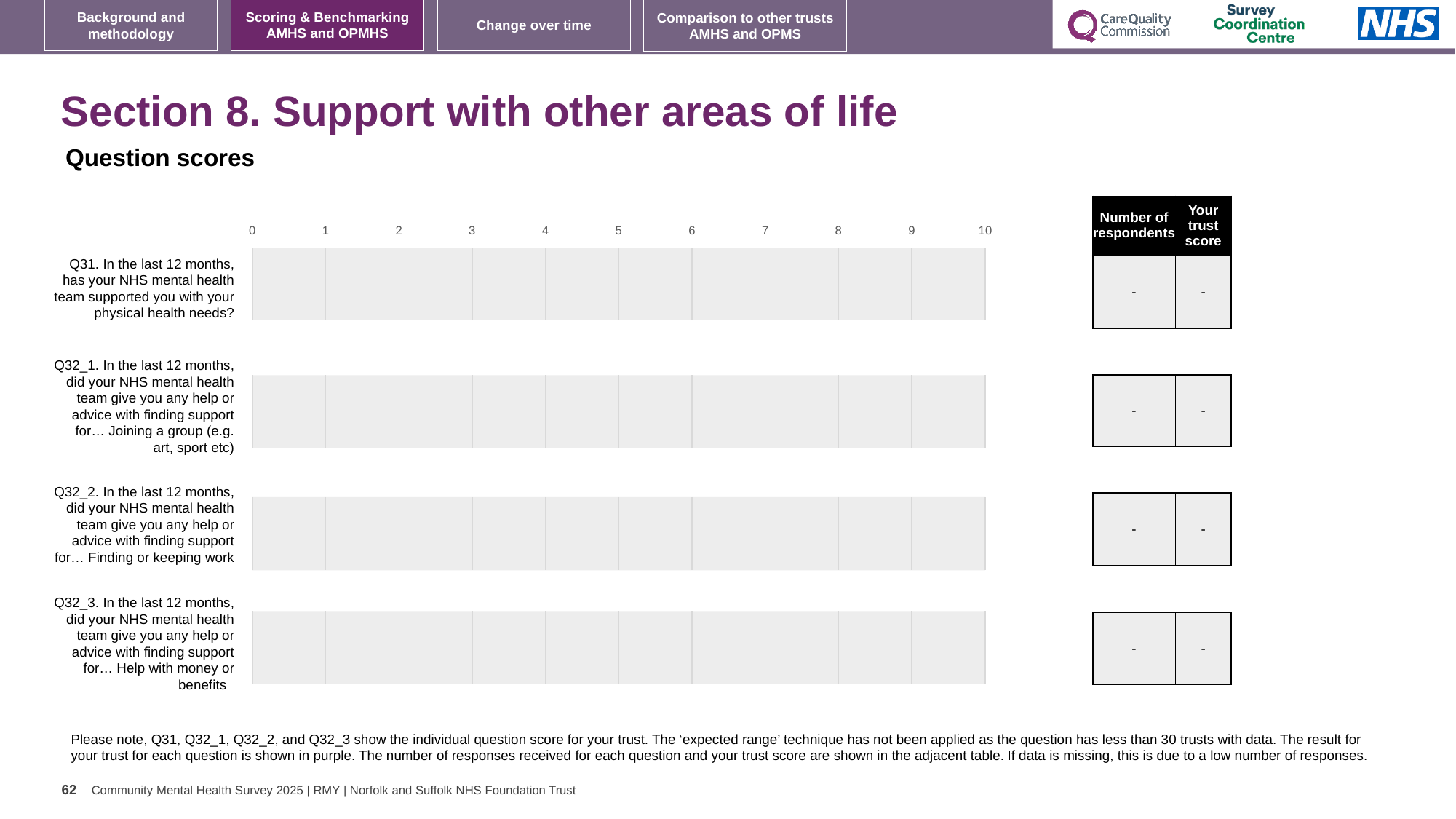
What is the lowest value shown on the chart's horizontal axis? 0 What is the number of respondents shown in the table for Q32_2? - Which question label is listed first (at the top) on the chart? Q31 How many questions (categories) are listed on the chart? 4 What is the number of respondents shown in the table for Q32_1? - What is the highest value shown on the chart's horizontal axis? 10 What is the trust score shown in the table for Q31? - What is the trust score shown in the table for Q32_3? -